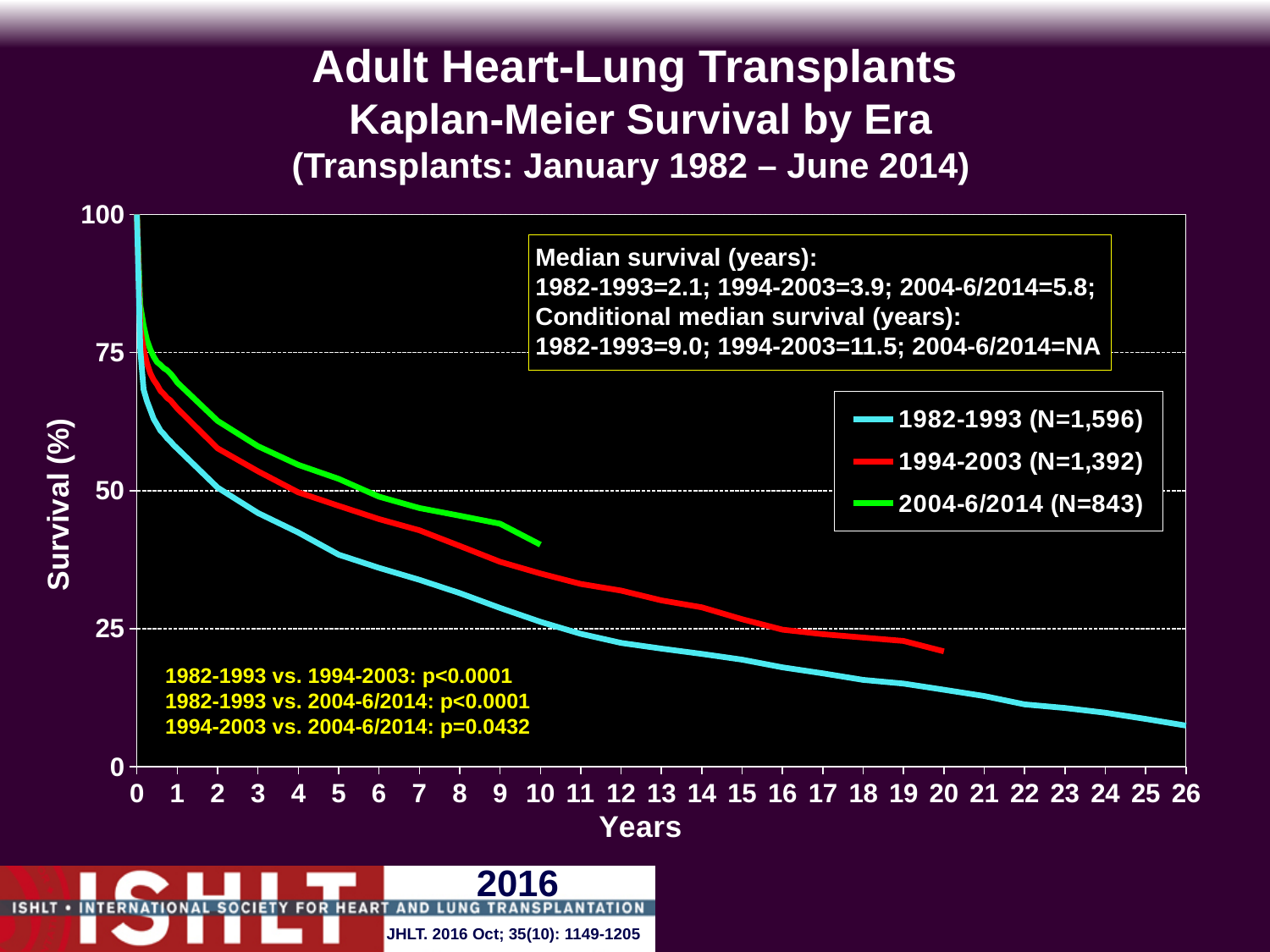
Is the survival for the 1994-2003 era at 10 years greater or less than 25? greater Which era has the highest median survival? 2004-6/2014 What is the N for the 2004-6/2014 era shown in the legend? 843 At 10 years, which era has higher survival, 2004-6/2014 or 1982-1993? 2004-6/2014 Do the survival curves rise or fall as years increase? fall What kind of chart is shown on the slide? line chart Is the survival for the 1982-1993 era at 5 years greater or less than 50? less What is the conditional median survival in years for the 1982-1993 era? 9.0 How many series does the legend list? 3 What is the difference in conditional median survival between the 1994-2003 era and the 1982-1993 era? 2.5 years What is the median survival in years for the 1994-2003 era? 3.9 What is the difference in median survival between the 2004-6/2014 era and the 1982-1993 era? 3.7 years